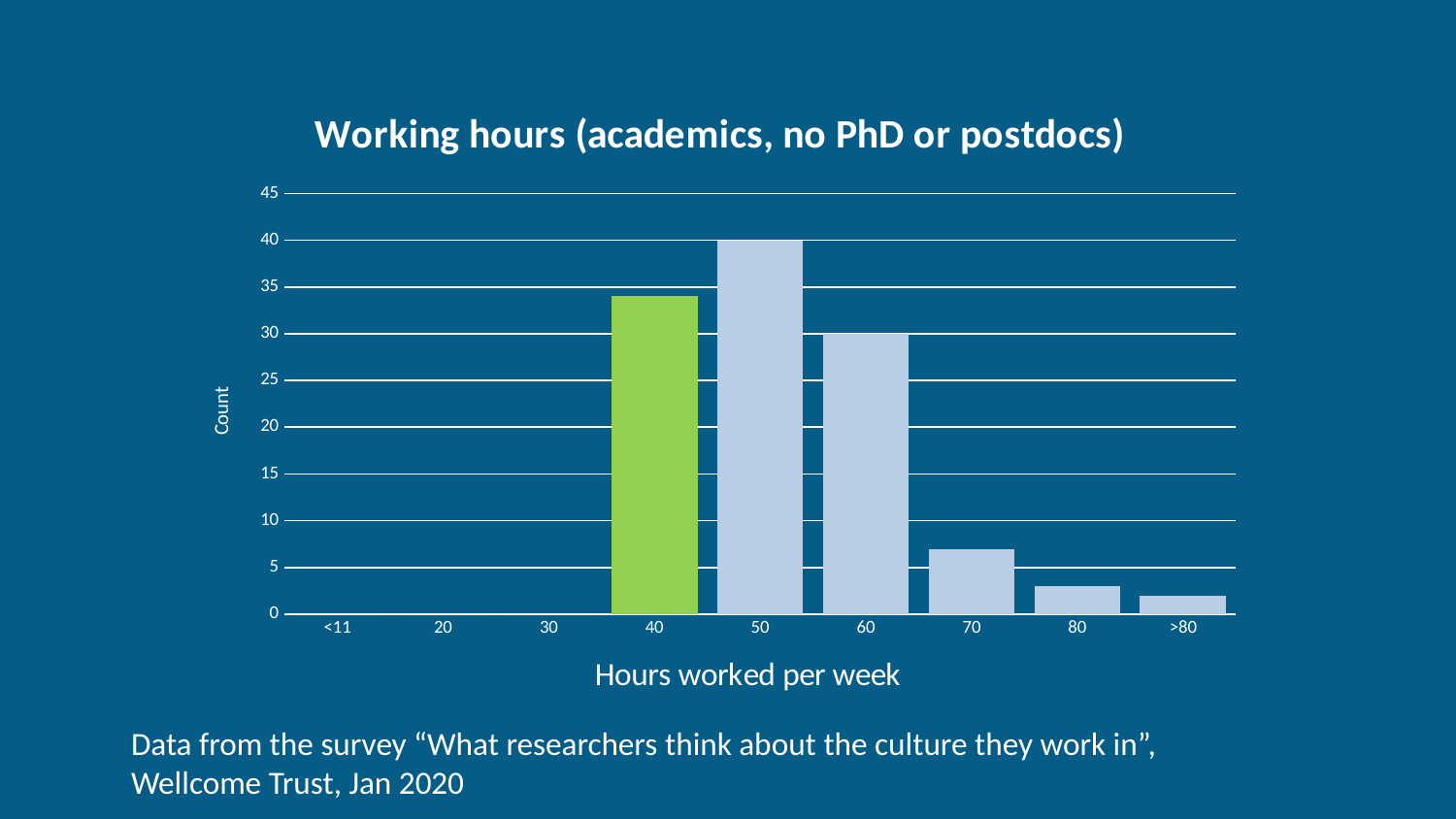
Which has a higher count, the 70 hours category or the 80 hours category? 70 Which has a higher count, the 40 hours category or the 60 hours category? 40 What is the count for the 50 hours worked per week category? 40 Is the count for the 70 hours category greater or less than 10? less How many hours-worked categories are shown on the x axis? 9 What is the title of the chart? Working hours (academics, no PhD or postdocs) Which category's bar is coloured green? 40 What kind of chart is shown on the slide? bar chart What is the difference between the counts for the 50 and 60 hours categories? 10 Which hours-worked category has the highest count? 50 What is the count for the 60 hours worked per week category? 30 Is the count for the 40 hours category greater or less than 30? greater